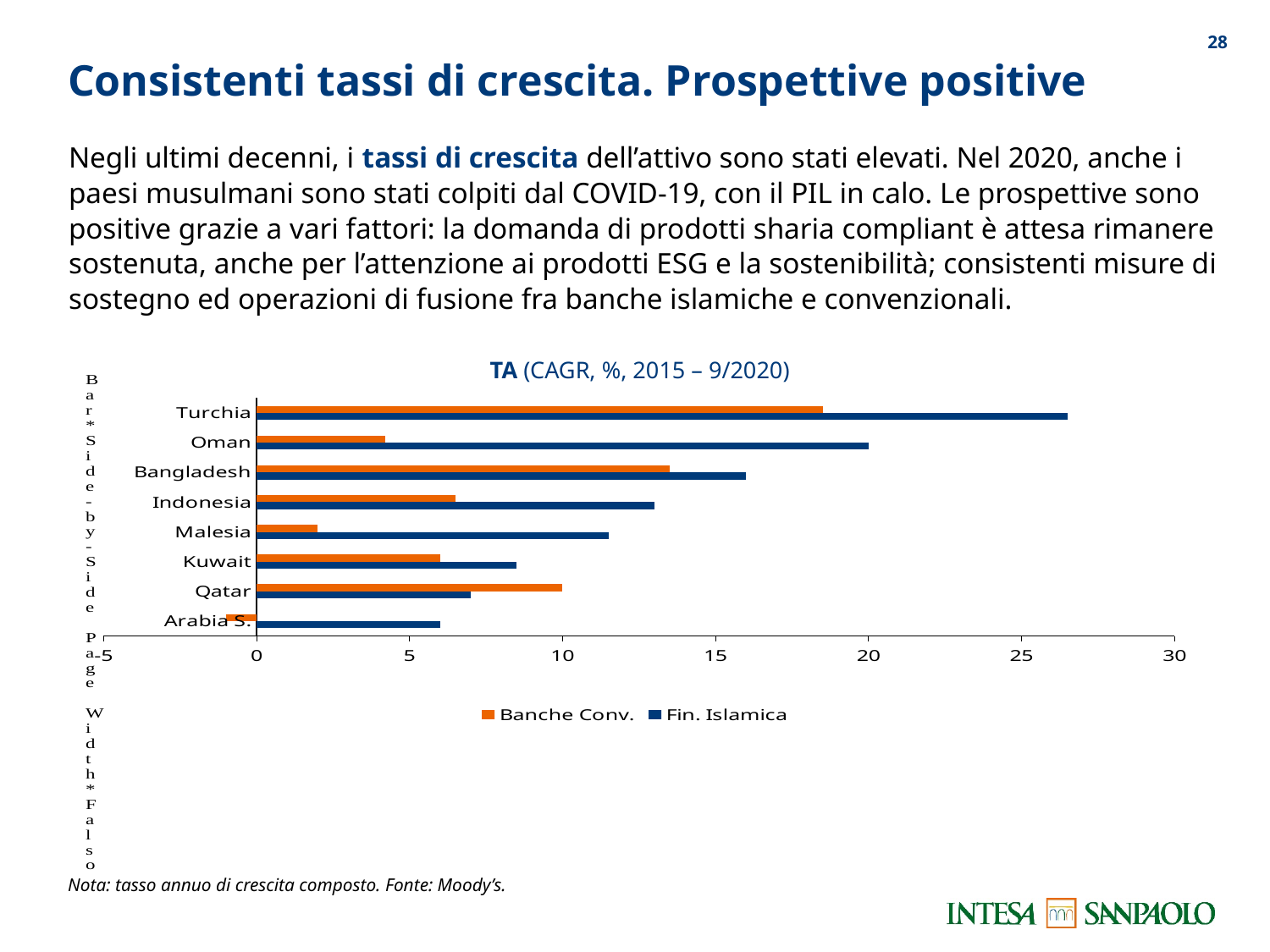
Which country has the lowest value for Banche Conv.? Arabia S. Is the Banche Conv. value for Arabia S. greater or less than 0? less How many series does the legend list? 2 Which country has the lowest value for Fin. Islamica? Arabia S. What kind of chart is shown on the slide? Bar chart How many countries are listed on the chart? 8 Is the Banche Conv. value for Oman greater or less than 5? less Is the Fin. Islamica value for Turchia greater or less than 25? greater Which country has the highest value for Fin. Islamica? Turchia For Qatar, which is larger: Banche Conv. or Fin. Islamica? Banche Conv. Which colour represents the Fin. Islamica series in the legend? Blue Which is larger for Fin. Islamica: Oman or Bangladesh? Oman